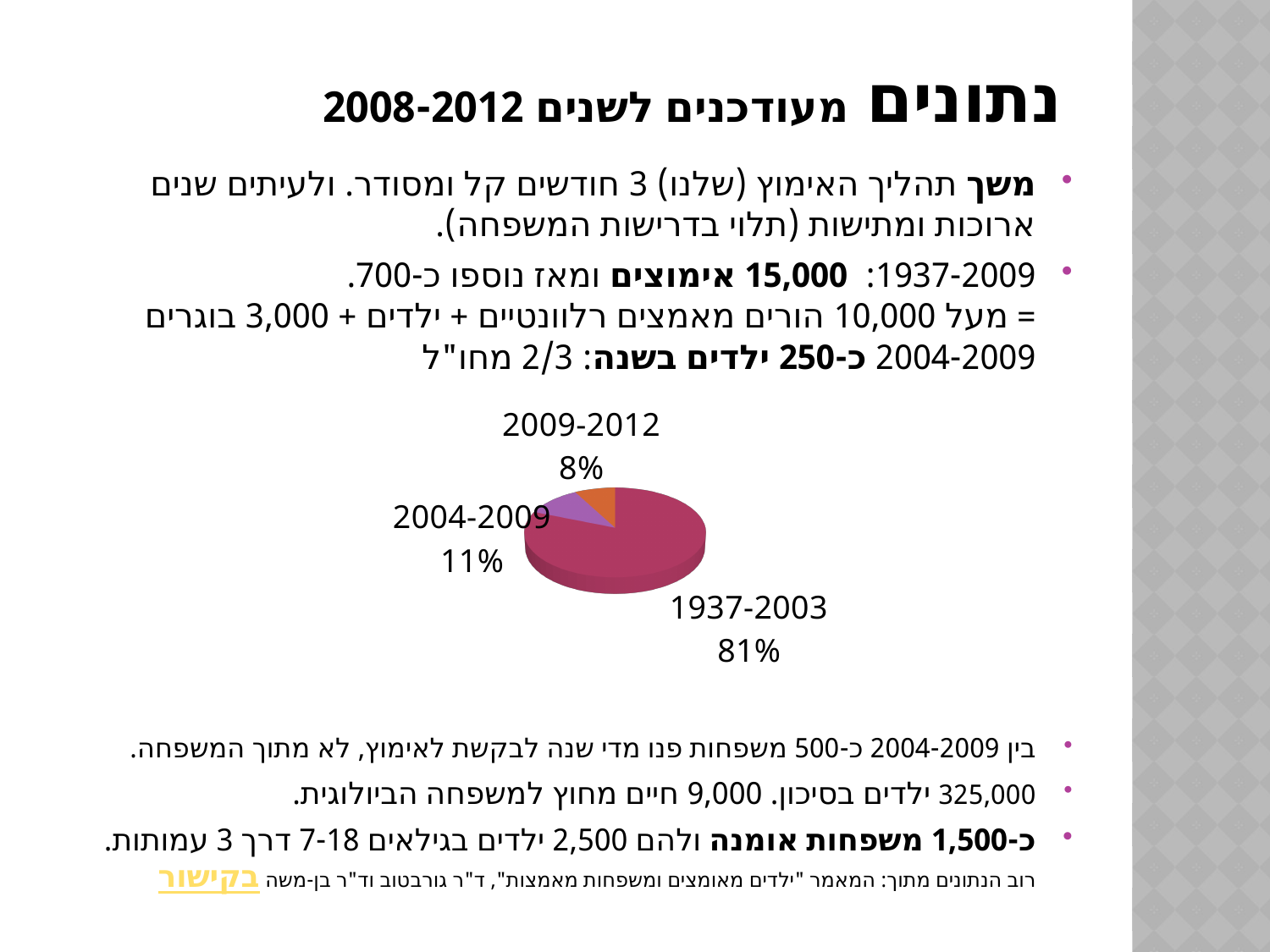
How many slices does the pie chart have? 3 What is the difference in percentage points between the 1937-2003 slice and the 2004-2009 slice? 70 What share of the pie does the 2004-2009 slice represent? 11% Which period has the smallest slice of the pie? 2009-2012 Which slice is larger, 2004-2009 or 2009-2012? 2004-2009 What colour is the largest slice of the pie chart? magenta/pink What kind of chart is shown on the slide? pie chart Is the share for 1937-2003 greater or less than 50%? greater What share of the pie does the 2009-2012 slice represent? 8% What share of the pie does the 1937-2003 slice represent? 81% What is the difference in percentage points between the 2004-2009 slice and the 2009-2012 slice? 3 Which period has the largest slice of the pie? 1937-2003